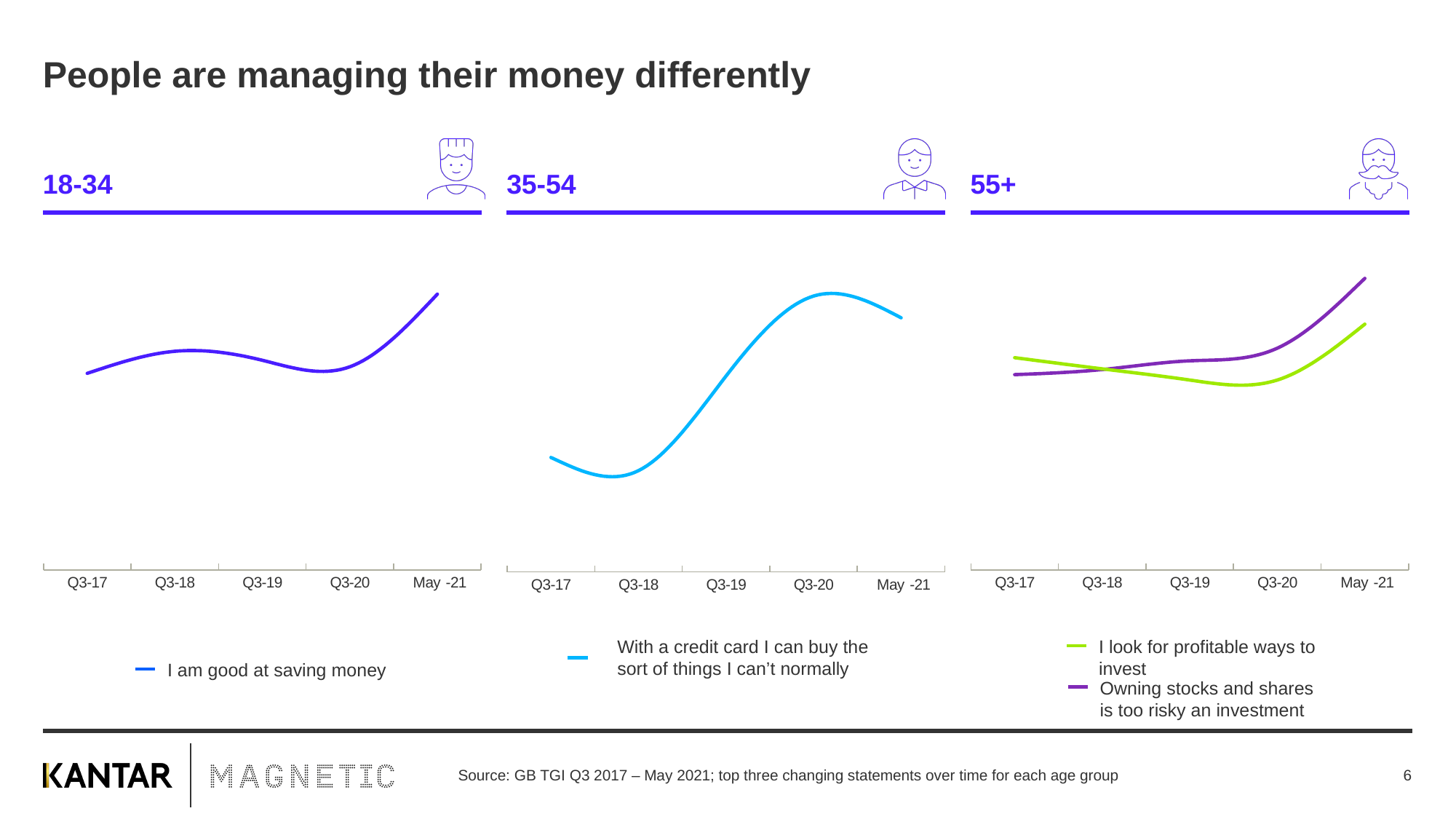
In the 55+ chart, which series is higher at May -21: 'I look for profitable ways to invest' or 'Owning stocks and shares is too risky an investment'? Owning stocks and shares is too risky an investment In the 35-54 chart, at which time point is the value for the credit card statement highest? Q3-20 In the 35-54 chart, at which time point is the value for the credit card statement lowest? Q3-18 In the 18-34 chart, at which time point is the value for 'I am good at saving money' highest? May -21 Which statement does the legend of the 18-34 chart show? I am good at saving money How many charts are shown on the slide? 3 In the 55+ chart, does the 'Owning stocks and shares is too risky an investment' line rise or fall between Q3-20 and May -21? rise How many series does the legend of the 55+ chart list? 2 How many time points are plotted on the x axis of the 35-54 chart? 5 What kind of chart is used for the 18-34 age group? line chart In the 35-54 chart, does the credit card statement line rise or fall between Q3-18 and Q3-20? rise